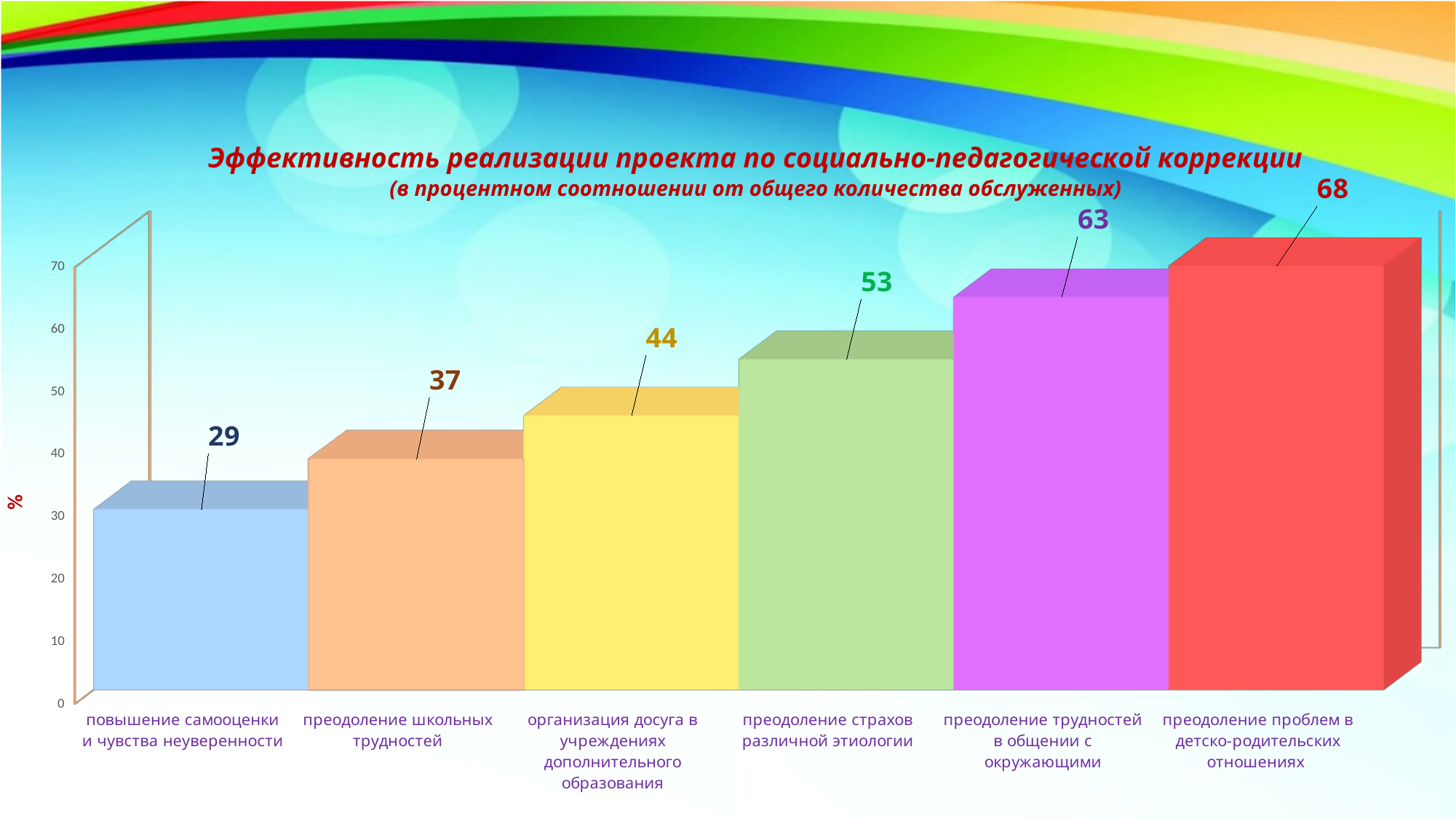
Which category has the lowest value? повышение самооценки и чувства неуверенности Which category has the highest value? преодоление проблем в детско-родительских отношениях What is the difference between the values for "организация досуга в учреждениях дополнительного образования" and "преодоление школьных трудностей"? 7 What is the difference between the values for "преодоление проблем в детско-родительских отношениях" and "повышение самооценки и чувства неуверенности"? 39 How many categories are shown in the chart? 6 Do the values rise or fall from left to right along the x axis? rise Which is larger: the value for "преодоление страхов различной этиологии" or the value for "организация досуга в учреждениях дополнительного образования"? преодоление страхов различной этиологии What is the value for "повышение самооценки и чувства неуверенности"? 29 What kind of chart is shown on the slide? bar chart What is the value for "преодоление трудностей в общении с окружающими"? 63 What is the label on the vertical axis of the chart? % What is the value for "преодоление страхов различной этиологии"? 53